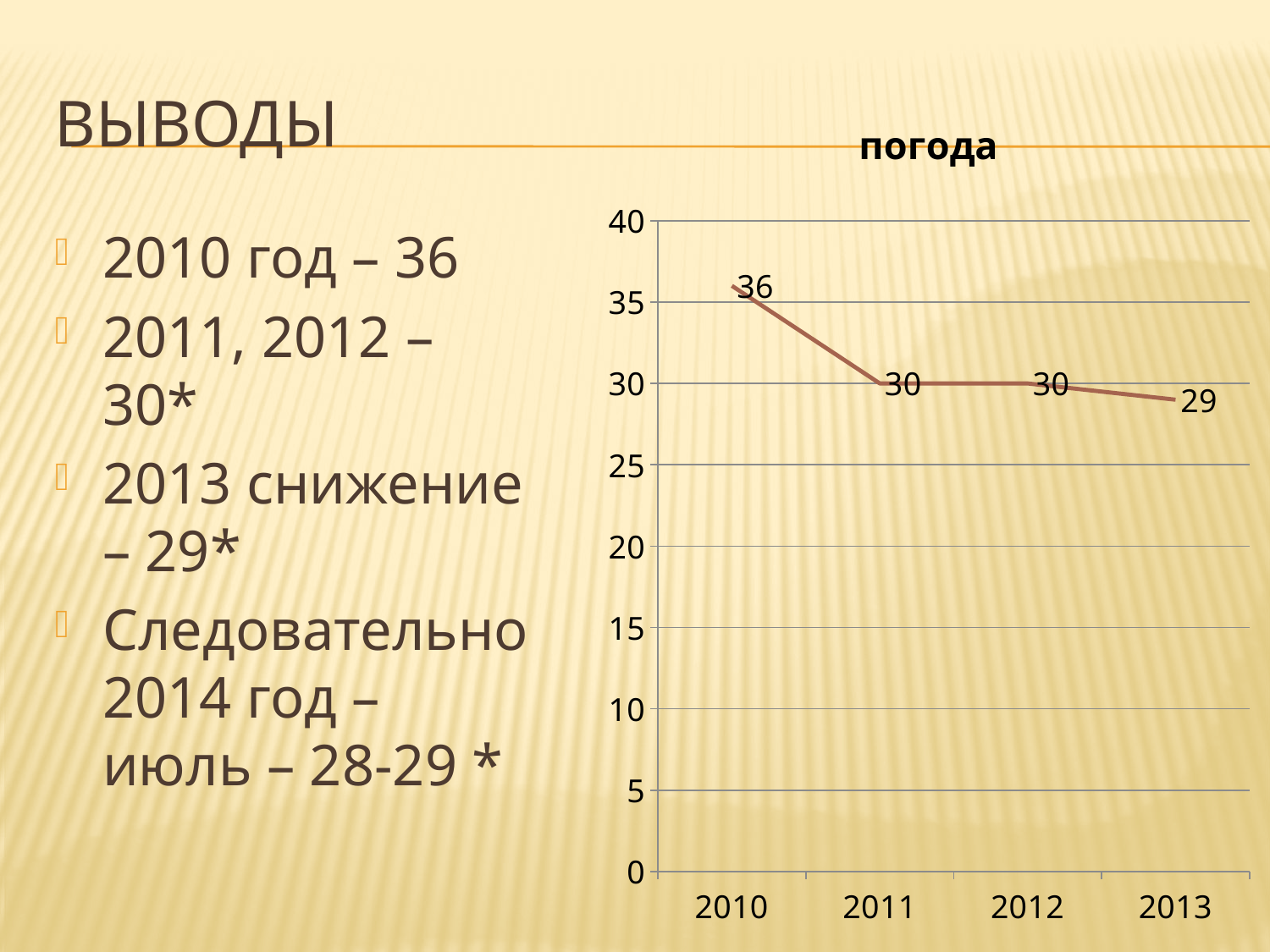
What is the value for 2011 in the chart? 30 What is the value for 2010 in the chart? 36 Which year has the lowest value in the chart? 2013 Is the value for 2013 greater or less than 30? less How many years are plotted on the x axis of the chart? 4 Do the values rise or fall from 2010 to 2013? fall What is the title of the chart? погода What is the difference between the values for 2010 and 2013? 7 What kind of chart is shown on the slide? line chart Which year has the highest value in the chart? 2010 Which is larger, the value for 2010 or the value for 2012? 2010 What is the value for 2013 in the chart? 29